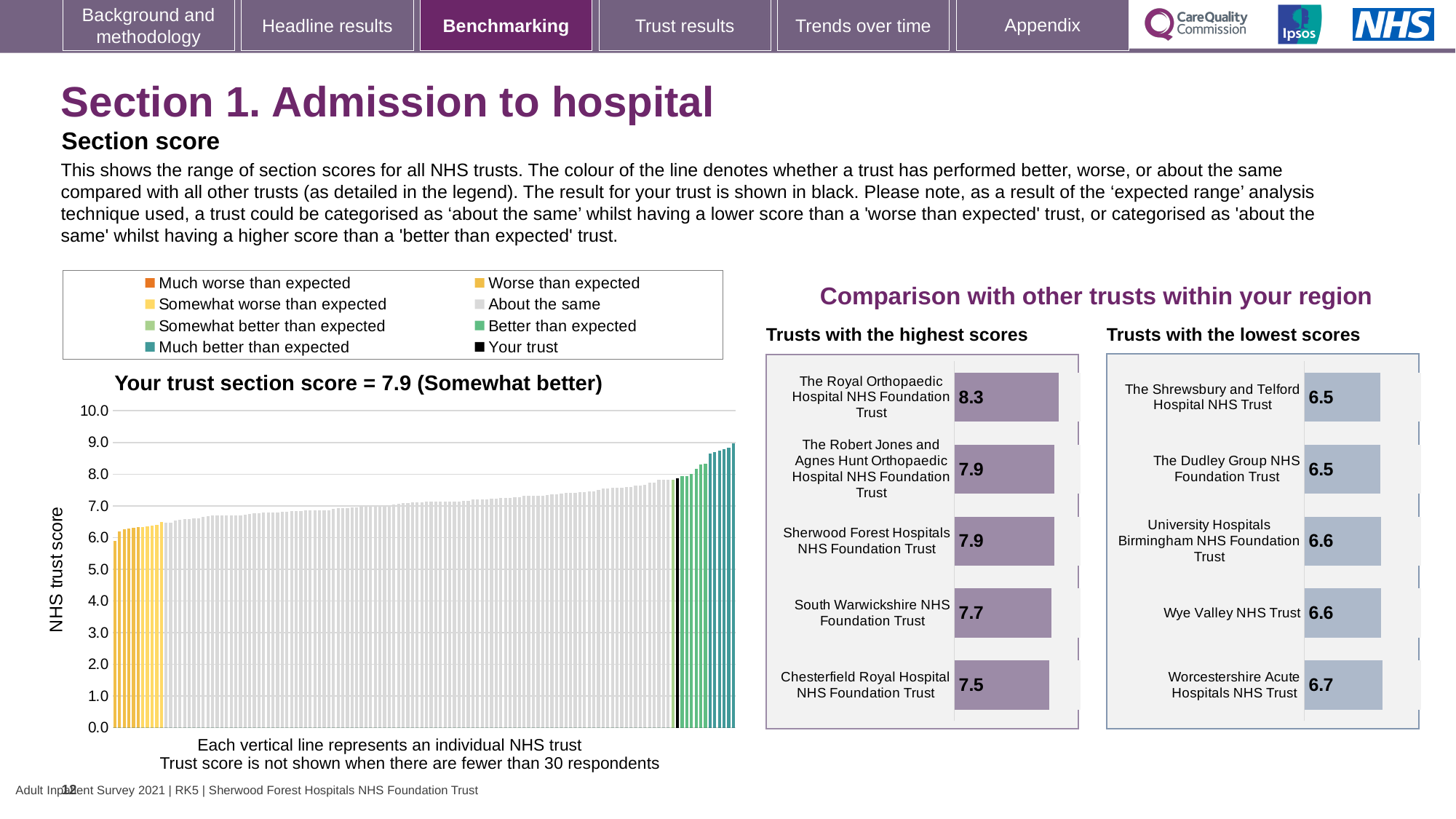
In the 'Trusts with the highest scores' chart, which trust has the lowest score? Chesterfield Royal Hospital NHS Foundation Trust In the 'Trusts with the lowest scores' chart, what is the score for University Hospitals Birmingham NHS Foundation Trust? 6.6 According to the title of the left-hand chart, what is your trust's section score? 7.9 In the 'Trusts with the lowest scores' chart, which trust has the highest score? Worcestershire Acute Hospitals NHS Trust In the 'Trusts with the lowest scores' chart, which has the larger score: The Dudley Group NHS Foundation Trust or Wye Valley NHS Trust? Wye Valley NHS Trust How many entries does the legend above the left-hand chart list? 8 In the left-hand chart, do the bar heights rise or fall from left to right? rise What kind of chart is the 'Your trust section score' chart on the left of the slide? bar chart In the 'Trusts with the highest scores' chart, what is the difference between the scores of The Royal Orthopaedic Hospital NHS Foundation Trust and Chesterfield Royal Hospital NHS Foundation Trust? 0.8 In the 'Trusts with the highest scores' chart, what is the score for The Royal Orthopaedic Hospital NHS Foundation Trust? 8.3 What is the y-axis label of the left-hand chart? NHS trust score How many trusts are shown in the 'Trusts with the highest scores' chart? 5